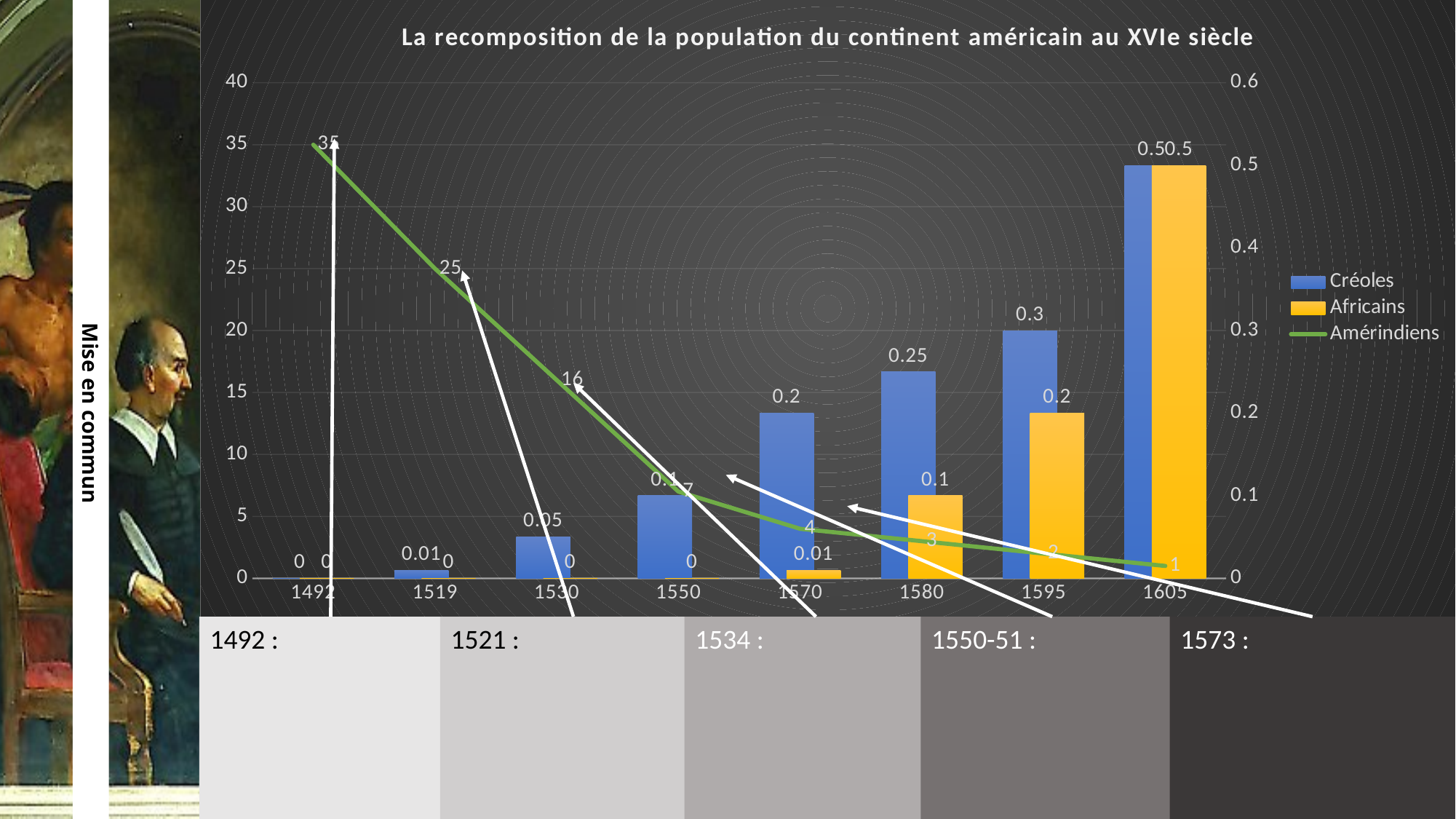
What is the value of the Créoles series in 1580? 0.25 In which year is the Amérindiens series lowest? 1605 What is the value of the Amérindiens series in 1492? 35 Does the Amérindiens series rise or fall from 1492 to 1605? Fall In which year is the Créoles series highest? 1605 In 1570, which is larger: the Créoles value or the Africains value? Créoles What kind of chart is used for the Créoles and Africains series? Bar chart What is the difference between the Amérindiens values in 1492 and 1519? 10 How many series does the legend list? 3 What is the value of the Africains series in 1570? 0.01 What is the title of the chart? La recomposition de la population du continent américain au XVIe siècle How many years are shown on the x axis? 8